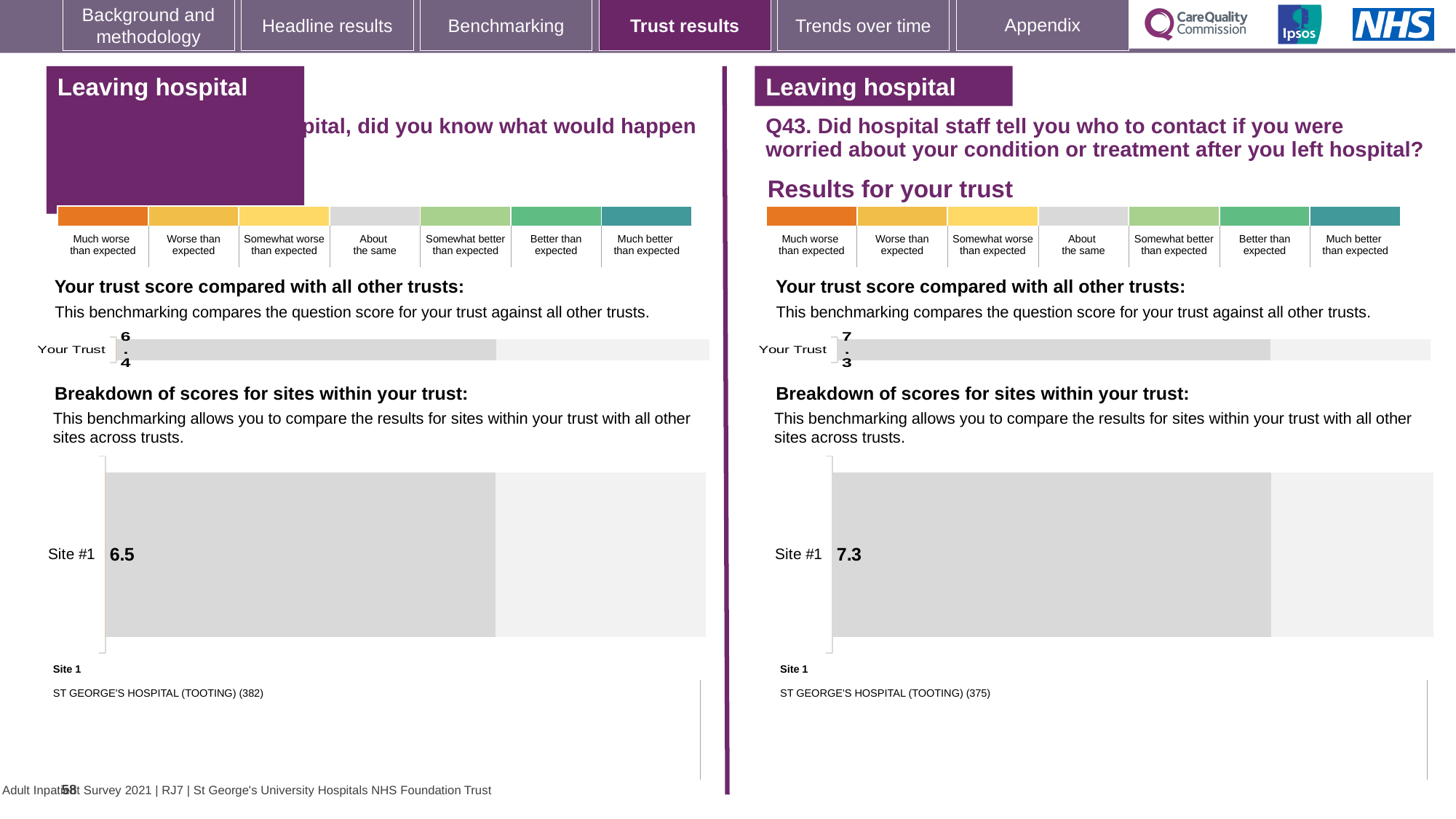
On the right-hand Q43 'Breakdown of scores for sites within your trust' chart, what is the value shown for Site #1? 7.3 On the right-hand Q43 side, which hospital is listed as Site 1 below the breakdown chart? ST GEORGE'S HOSPITAL (TOOTING) On the left-hand 'Breakdown of scores for sites within your trust' chart, what is the value shown for Site #1? 6.5 Which Your Trust score is larger: the one on the right-hand Q43 chart or the one on the left-hand chart? The right-hand Q43 chart On the left-hand 'Your trust score compared with all other trusts' chart, what is the value shown for Your Trust? 6.4 What is the difference between the Your Trust score on the right-hand Q43 chart and the Your Trust score on the left-hand chart? 0.9 On the right-hand Q43 'Your trust score compared with all other trusts' chart, what is the value shown for Your Trust? 7.3 What type of chart is used for the 'Breakdown of scores for sites within your trust' on the right-hand Q43 side? Bar chart How many sites are plotted on the right-hand Q43 'Breakdown of scores for sites within your trust' chart? 1 On the right-hand Q43 side, what number is shown in brackets after the Site 1 hospital name? 375 On the left-hand side of the slide, what is the difference between the Site #1 score and the Your Trust score? 0.1 On the left-hand side of the slide, which is larger: the Site #1 score or the Your Trust score? Site #1